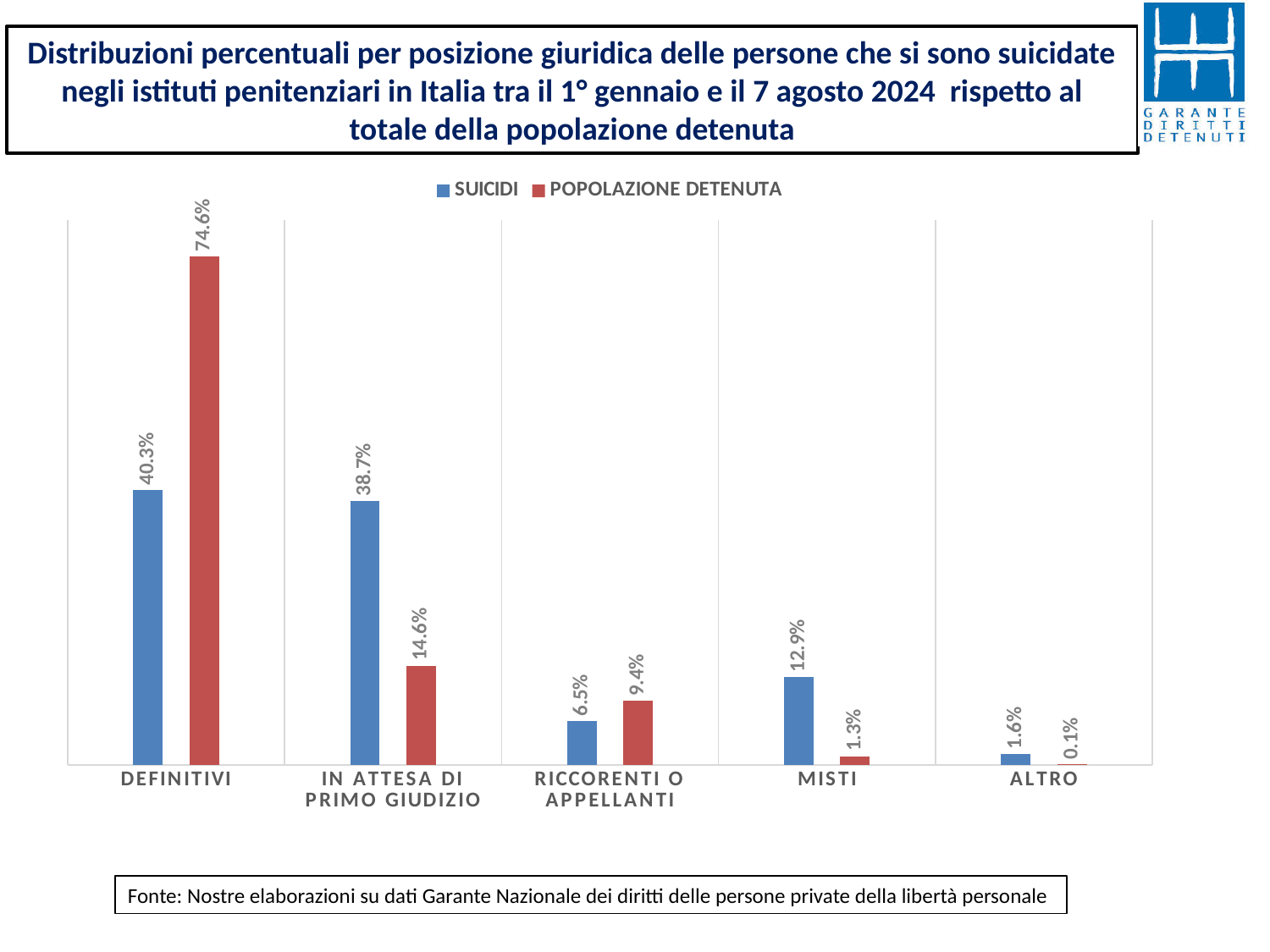
What is the SUICIDI value for DEFINITIVI? 40.3% How many series does the legend list? 2 Which category has the highest POPOLAZIONE DETENUTA value? DEFINITIVI Which category has the lowest SUICIDI value? ALTRO What is the POPOLAZIONE DETENUTA value for ALTRO? 0.1% What kind of chart is shown on the slide? Bar chart How many categories are shown on the x axis? 5 For RICCORENTI O APPELLANTI, which series has the larger value, SUICIDI or POPOLAZIONE DETENUTA? POPOLAZIONE DETENUTA What is the SUICIDI value for MISTI? 12.9% What is the difference between the POPOLAZIONE DETENUTA and SUICIDI values for DEFINITIVI? 34.3% What is the POPOLAZIONE DETENUTA value for IN ATTESA DI PRIMO GIUDIZIO? 14.6% What is the difference between the SUICIDI and POPOLAZIONE DETENUTA values for IN ATTESA DI PRIMO GIUDIZIO? 24.1%